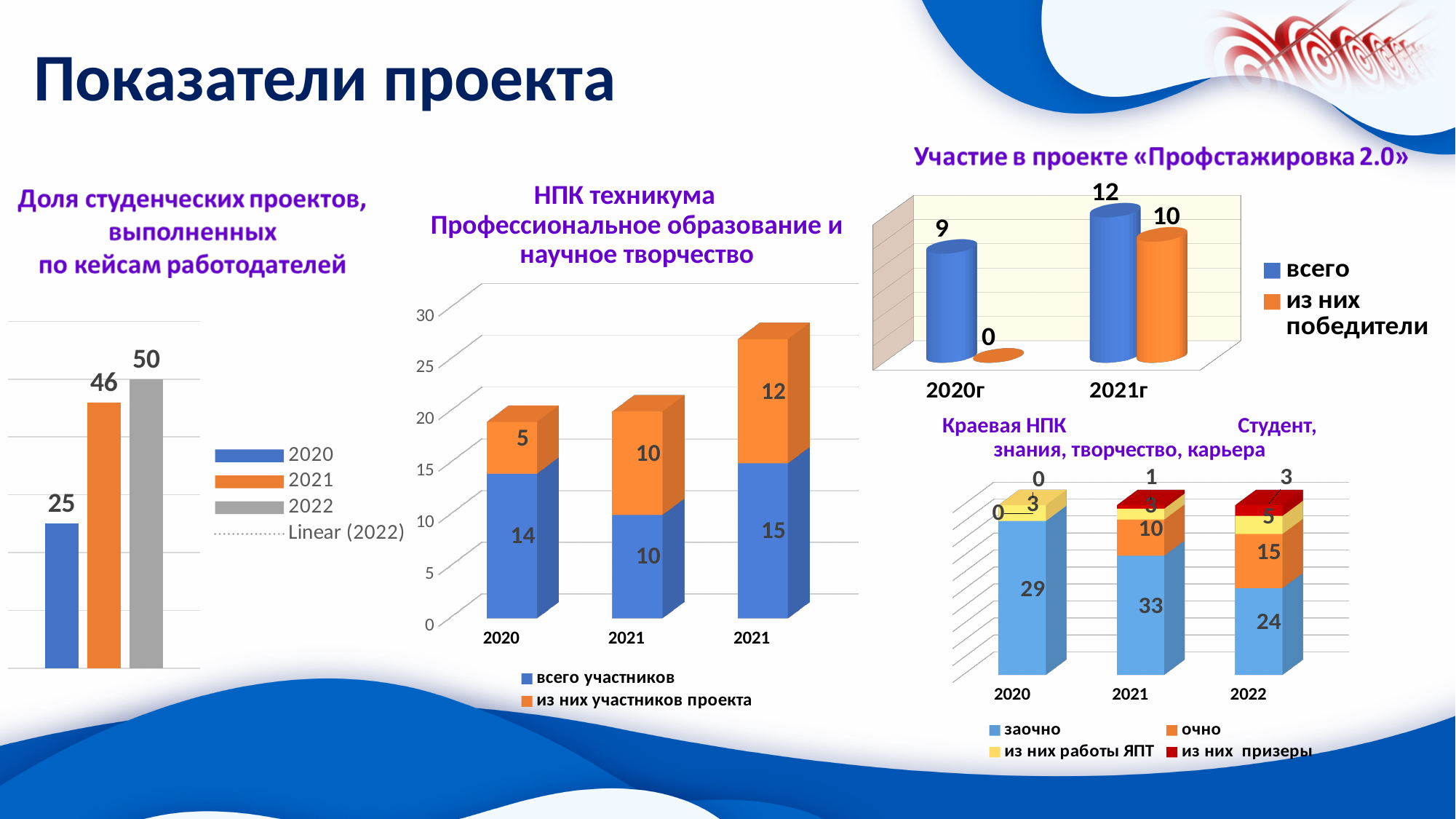
In the chart 'Доля студенческих проектов, выполненных по кейсам работодателей', do the values rise or fall from 2020 to 2022? rise In the chart 'Доля студенческих проектов, выполненных по кейсам работодателей', what is the value for 2021? 46 How many series does the legend of the chart 'НПК техникума Профессиональное образование и научное творчество' list? 2 In the chart 'Участие в проекте «Профстажировка 2.0»', what is the value of 'всего' for 2021г? 12 In the chart 'НПК техникума Профессиональное образование и научное творчество', what is the total of the rightmost stacked bar? 27 In the chart 'Участие в проекте «Профстажировка 2.0»', what is the value of 'из них победители' for 2020г? 0 In the chart 'Доля студенческих проектов, выполненных по кейсам работодателей', what is the difference between the 2022 and 2020 values? 25 How many series does the legend of the chart 'Краевая НПК Студент, знания, творчество, карьера' list? 4 In the chart 'Краевая НПК Студент, знания, творчество, карьера', what is the value of 'заочно' for 2021? 33 In the chart 'НПК техникума Профессиональное образование и научное творчество', what is the value of 'всего участников' for 2020? 14 In the chart 'Доля студенческих проектов, выполненных по кейсам работодателей', which year has the highest value? 2022 In the chart 'НПК техникума Профессиональное образование и научное творчество', what is the total of the stacked bar for 2020? 19